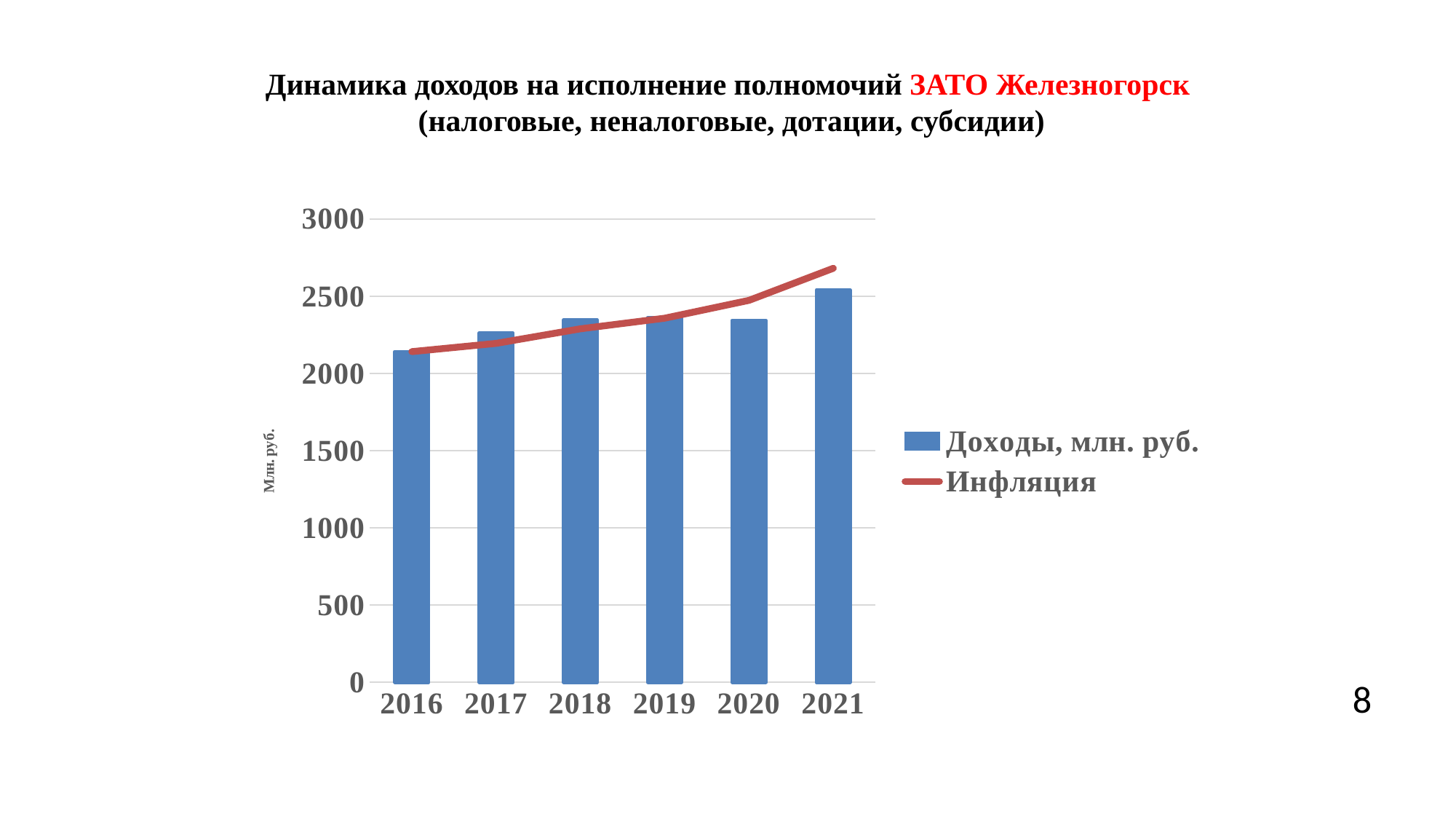
What are the two entries listed in the chart legend? Доходы, млн. руб. and Инфляция Is the value for Доходы, млн. руб. in 2020 greater or less than 2500? less What kind of chart is shown on the slide? A bar chart combined with a line chart Which year has the highest value for Доходы, млн. руб.? 2021 How many series does the legend list? 2 Which year has the lowest value for Доходы, млн. руб.? 2016 What colour is the Инфляция line in the chart? Red How many years are shown on the x axis of the chart? 6 Is the value for Доходы, млн. руб. in 2016 greater or less than 2000? greater Which is larger, the Доходы value for 2016 or for 2021? 2021 Does the Инфляция line rise or fall from 2016 to 2021? It rises Is the value for Доходы, млн. руб. in 2021 greater or less than 2500? greater